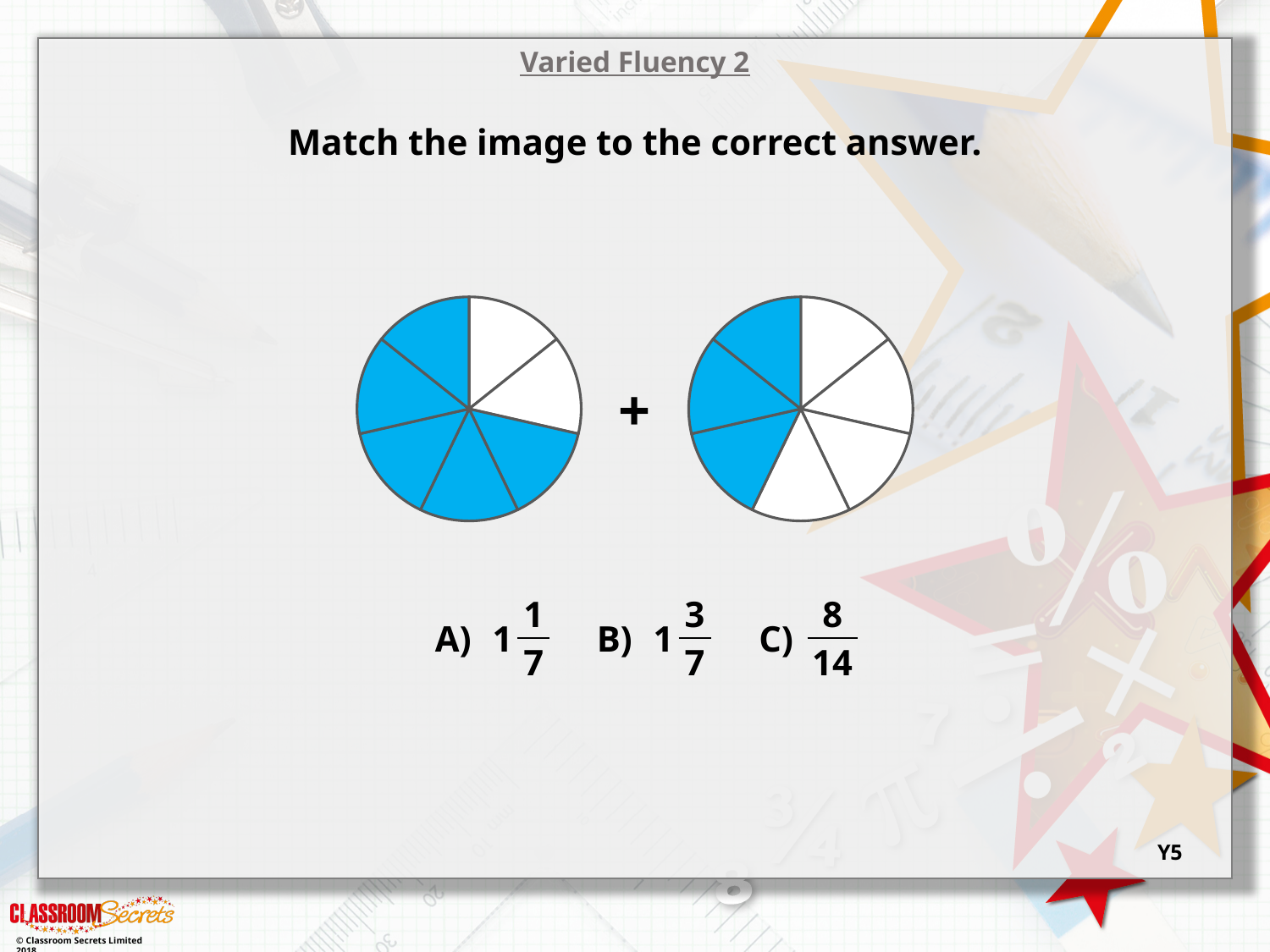
Which circle has more blue shaded parts, the left or the right? left What colour is used to shade the parts of the circles? blue How many parts of the left circle are shaded blue? 5 How many equal parts is the left circle divided into? 7 How many equal parts is the right circle divided into? 7 What symbol is shown between the two circles? + What is the difference between the number of blue parts in the left circle and the right circle? 2 What fraction of the right circle is shaded blue? 3/7 What fraction of the left circle is shaded blue? 5/7